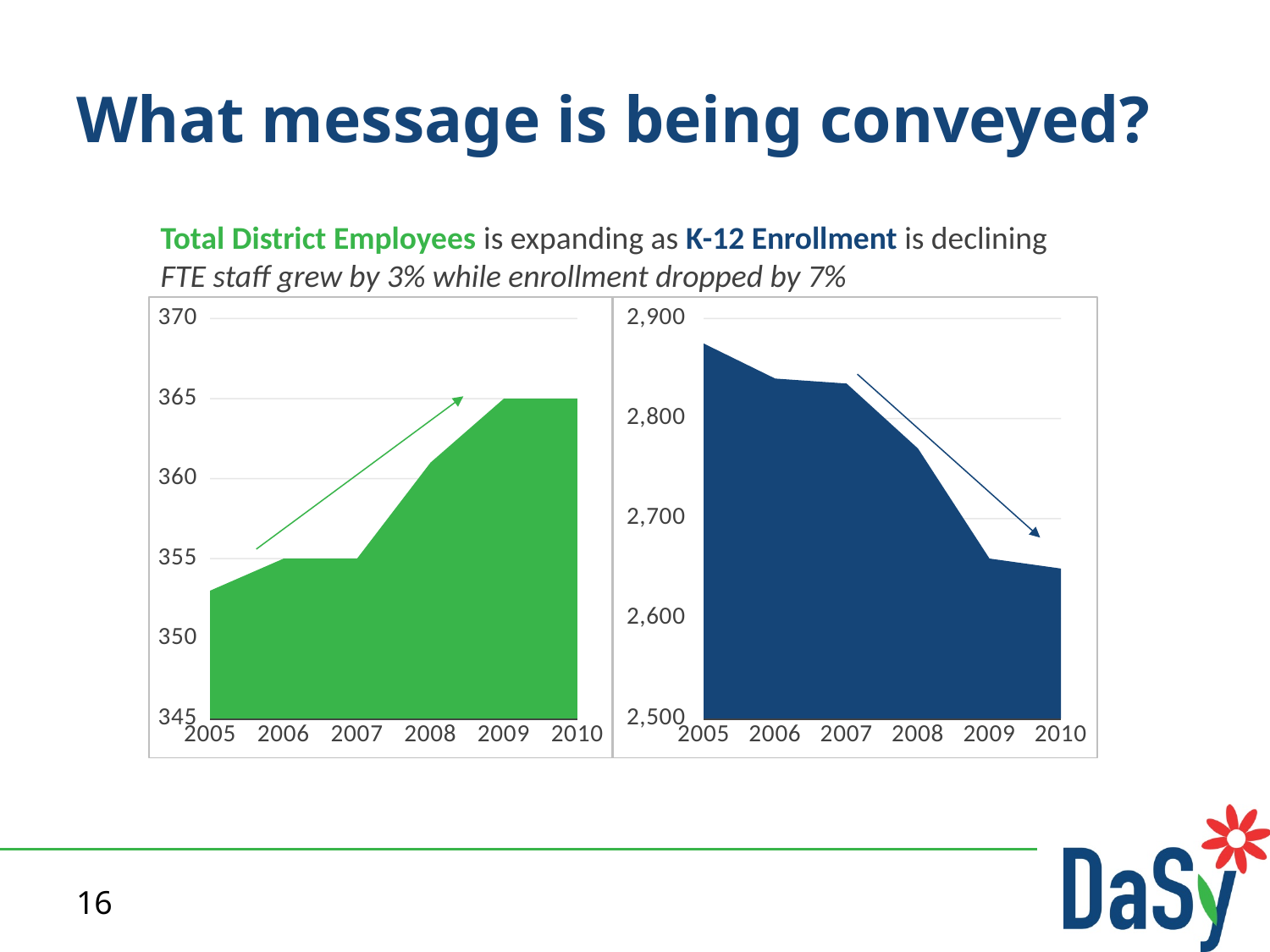
In the left chart (Total District Employees), what is the value for 2009? 365 In the left chart (Total District Employees), do the values rise or fall from 2005 to 2010? rise In the right chart (K-12 Enrollment), which is larger, the value for 2007 or the value for 2009? 2007 In the right chart (K-12 Enrollment), which year has the highest value? 2005 In the left chart (Total District Employees), is the value for 2005 greater or less than 355? less In the left chart (Total District Employees), which year has the lowest value? 2005 In the right chart (K-12 Enrollment), do the values rise or fall from 2005 to 2010? fall In the right chart (K-12 Enrollment), is the value for 2005 greater or less than 2,800? greater How many years are shown on the x axis of the right chart (K-12 Enrollment)? 6 What colour is the filled area in the left chart (Total District Employees)? green What kind of chart is the left chart (Total District Employees)? area chart In the right chart (K-12 Enrollment), is the value for 2010 greater or less than 2,700? less